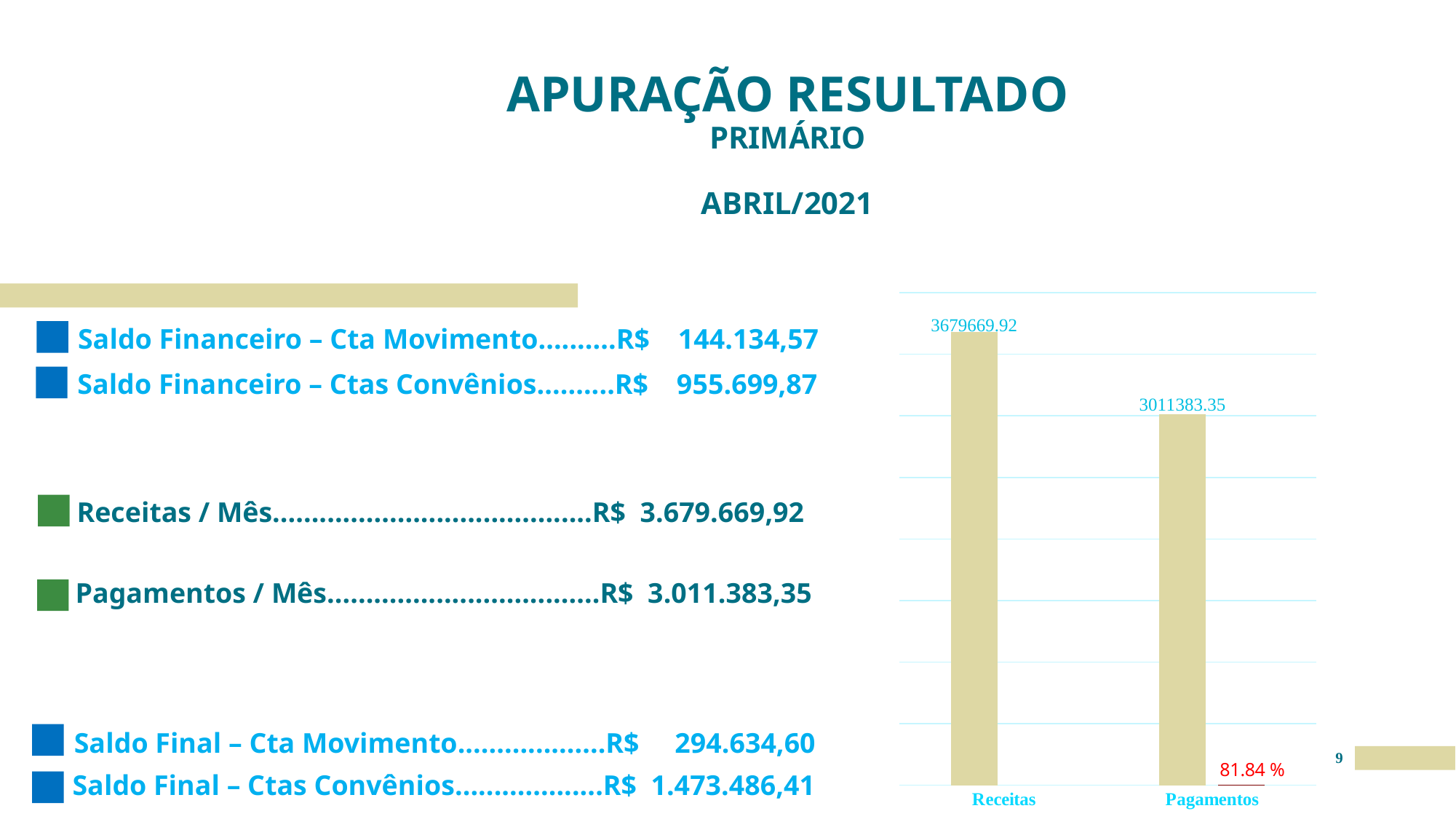
What type of chart is shown on the slide? Bar chart Which category has the lowest bar in the chart? Pagamentos Which category has the highest bar in the chart? Receitas What is the difference between the Receitas and Pagamentos values in the chart? 668286.57 How many bars are plotted in the chart? 2 What are the two category labels on the x axis of the chart? Receitas and Pagamentos What is the value shown for Receitas in the bar chart? 3679669.92 Which is larger in the chart, Receitas or Pagamentos? Receitas What is the value shown for Pagamentos in the bar chart? 3011383.35 What percentage is printed in red next to the Pagamentos bar? 81.84 %